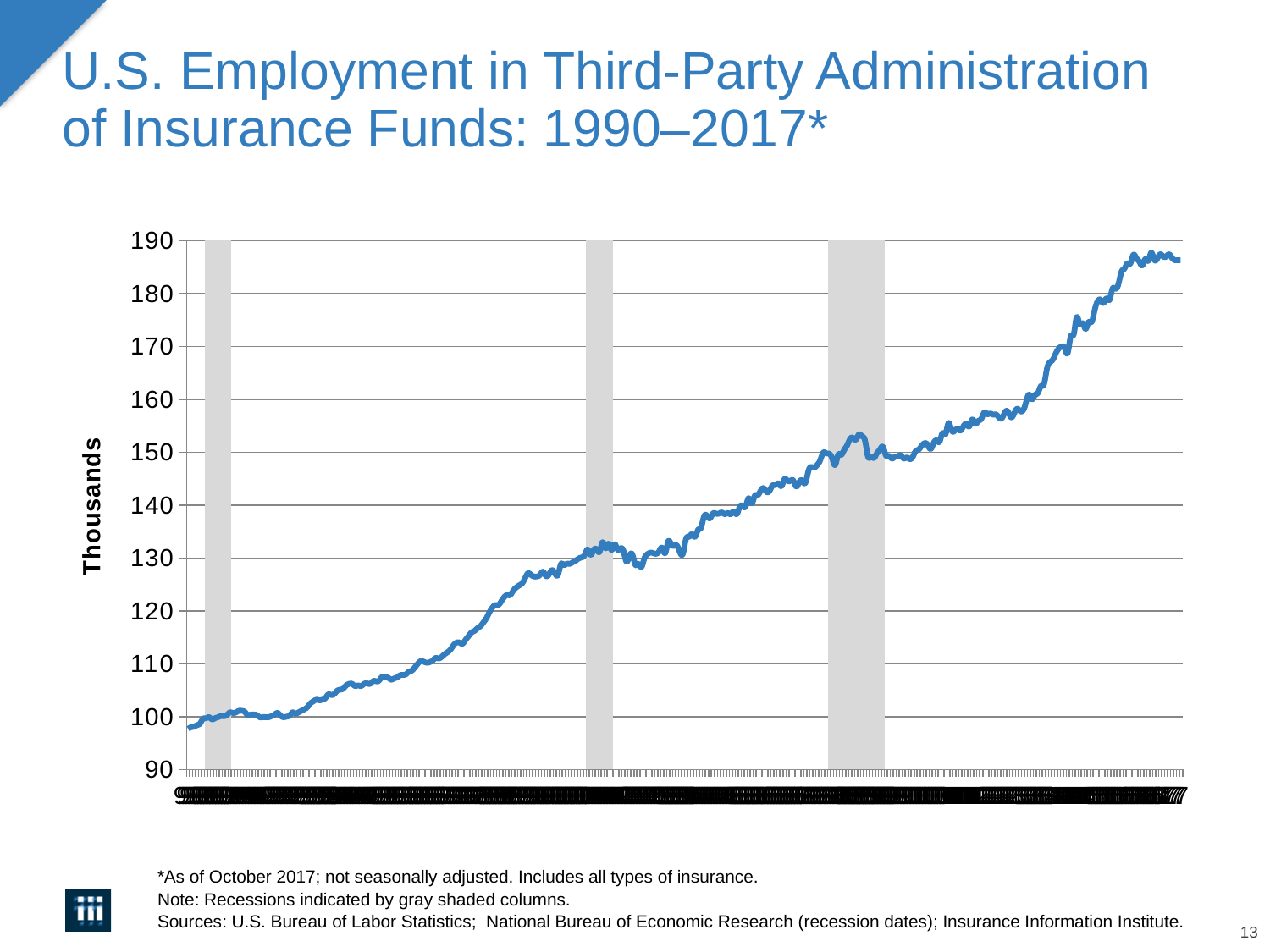
What kind of chart is shown on the slide? line chart Is the highest point of the line greater or less than 190? less Which is larger, the value at the start of the series or the value at the end of the series? the end of the series Is the value at the right end of the line (the most recent point) greater or less than 180? greater Do the values generally rise or fall from left to right along the x axis? rise How many gray shaded columns appear on the chart? 3 Is the value of the line during the second gray shaded column greater or less than 140? less What is the label on the vertical axis? Thousands